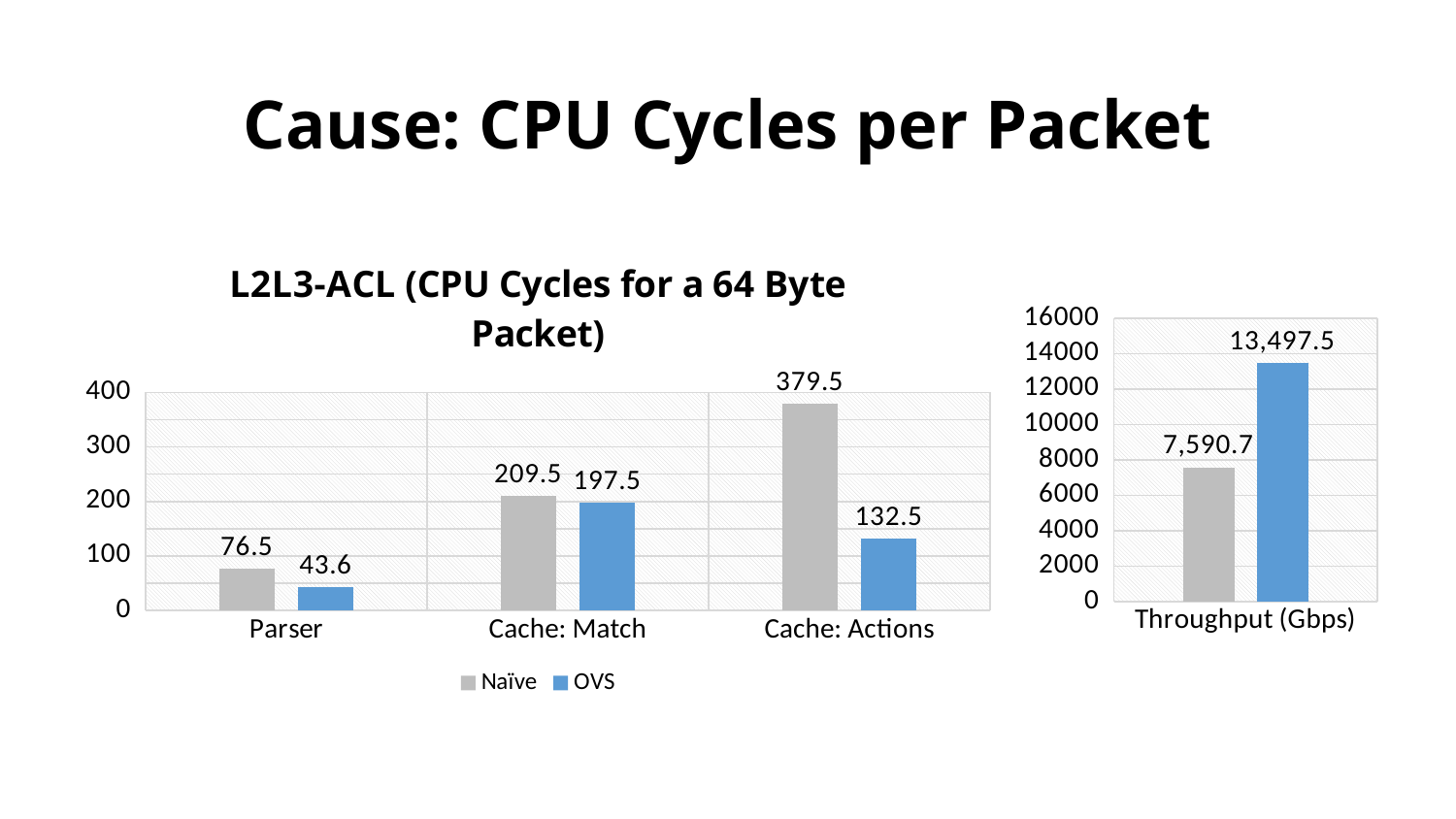
In the chart on the right of the slide, what is the value of the blue bar for Throughput (Gbps)? 13,497.5 In the L2L3-ACL chart, which category has the lowest OVS value? Parser In the L2L3-ACL chart, which is larger for Cache: Match, the Naïve value or the OVS value? Naïve In the L2L3-ACL chart, what is the difference between the Naïve and OVS values for Parser? 32.9 In the L2L3-ACL chart, what is the Naïve value for Cache: Actions? 379.5 In the L2L3-ACL chart, which category has the highest Naïve value? Cache: Actions How many series does the legend of the L2L3-ACL chart list? 2 In the L2L3-ACL chart, what is the difference between the Naïve and OVS values for Cache: Actions? 247 In the chart on the right of the slide, what is the difference between the blue bar and the gray bar for Throughput (Gbps)? 5,906.8 In the L2L3-ACL chart, what is the OVS value for Cache: Match? 197.5 In the L2L3-ACL chart, what is the OVS value for Parser? 43.6 How many categories are shown on the x axis of the L2L3-ACL chart? 3